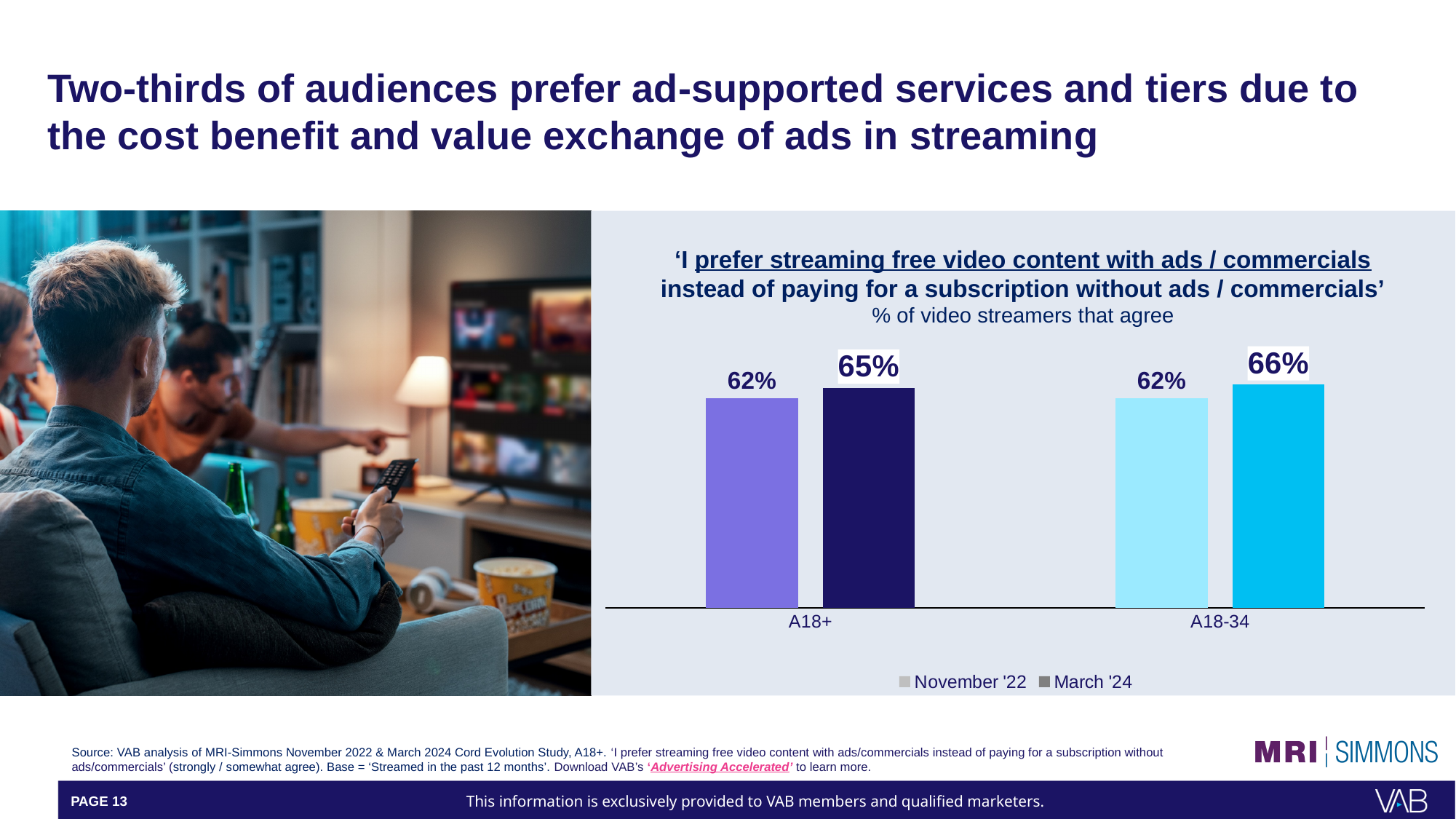
What kind of chart is shown on the slide? Bar chart What is the difference between the March '24 and November '22 values for A18+? 3% How many series does the legend list? 2 What is the March '24 value for A18-34? 66% Which is larger for A18+: the November '22 value or the March '24 value? March '24 Which category has the highest March '24 value? A18-34 What is the November '22 value for A18-34? 62% What are the two series named in the legend? November '22 and March '24 What is the November '22 value for A18+? 62% What is the March '24 value for A18+? 65% What is the difference between the March '24 and November '22 values for A18-34? 4% How many age categories are shown on the x axis? 2